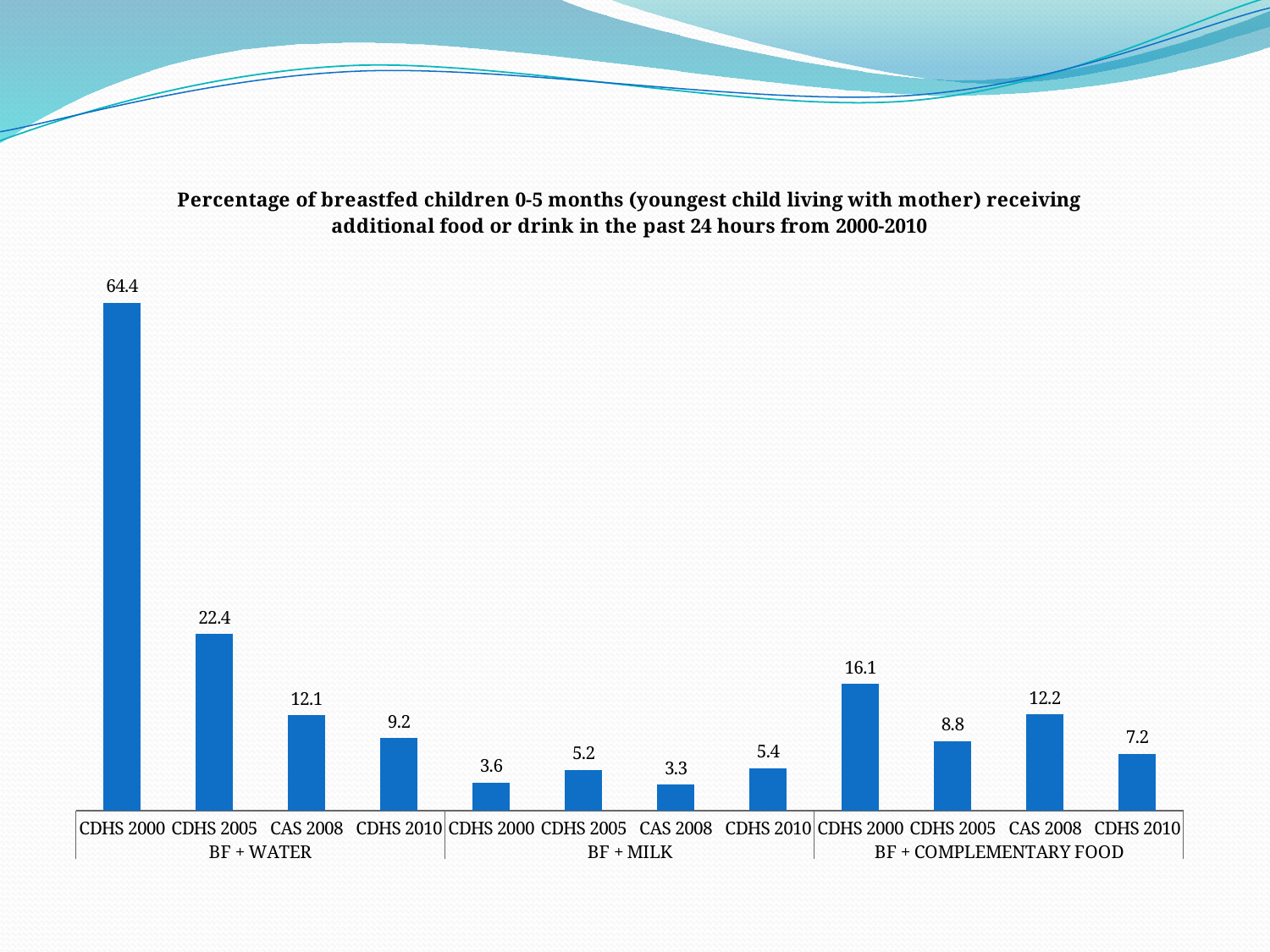
What kind of chart is shown on the slide? Bar chart How many bars are plotted on the chart? 12 What is the value for CDHS 2010 in the BF + COMPLEMENTARY FOOD group? 7.2 What is the difference between CDHS 2000 and CDHS 2010 in the BF + COMPLEMENTARY FOOD group? 8.9 What is the value for CDHS 2000 in the BF + WATER group? 64.4 How many groups of categories are shown along the x axis? 3 Which bar has the highest value on the chart? CDHS 2000, BF + WATER What is the difference between CDHS 2000 and CDHS 2005 in the BF + WATER group? 42.0 What is the value for CAS 2008 in the BF + MILK group? 3.3 Do the values in the BF + WATER group rise or fall from CDHS 2000 to CDHS 2010? Fall Which bar has the lowest value on the chart? CAS 2008, BF + MILK Which is larger: CAS 2008 in BF + WATER or CAS 2008 in BF + COMPLEMENTARY FOOD? CAS 2008 in BF + COMPLEMENTARY FOOD